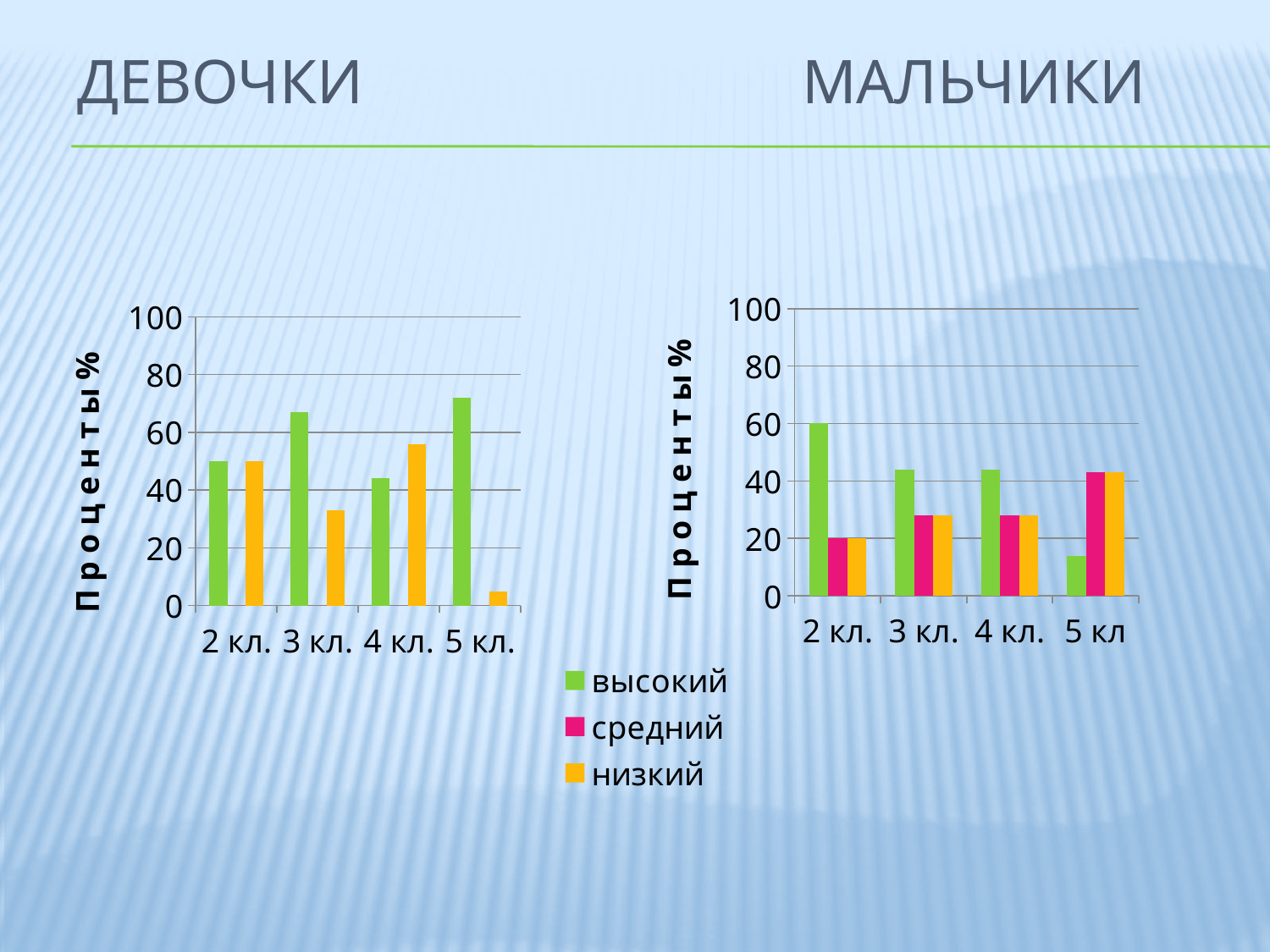
On the ДЕВОЧКИ chart, is the value for низкий in 4 кл. greater or less than 40? greater On the МАЛЬЧИКИ chart, which is larger in 2 кл.: высокий or средний? высокий On the ДЕВОЧКИ chart, how many class categories are shown on the x axis? 4 On the МАЛЬЧИКИ chart, which class has the highest value for высокий? 2 кл. On the МАЛЬЧИКИ chart, which class has the lowest value for высокий? 5 кл On the ДЕВОЧКИ chart, is the value for высокий in 3 кл. greater or less than 60? greater On the ДЕВОЧКИ chart, which class has the lowest value for низкий? 5 кл. On the ДЕВОЧКИ chart, what kind of chart is shown? bar chart On the ДЕВОЧКИ chart, which class has the highest value for высокий? 5 кл. On the МАЛЬЧИКИ chart, is the value for средний in 5 кл greater or less than 40? greater What is the title of the vertical axis on the МАЛЬЧИКИ chart? Проценты% How many series does the legend list? 3